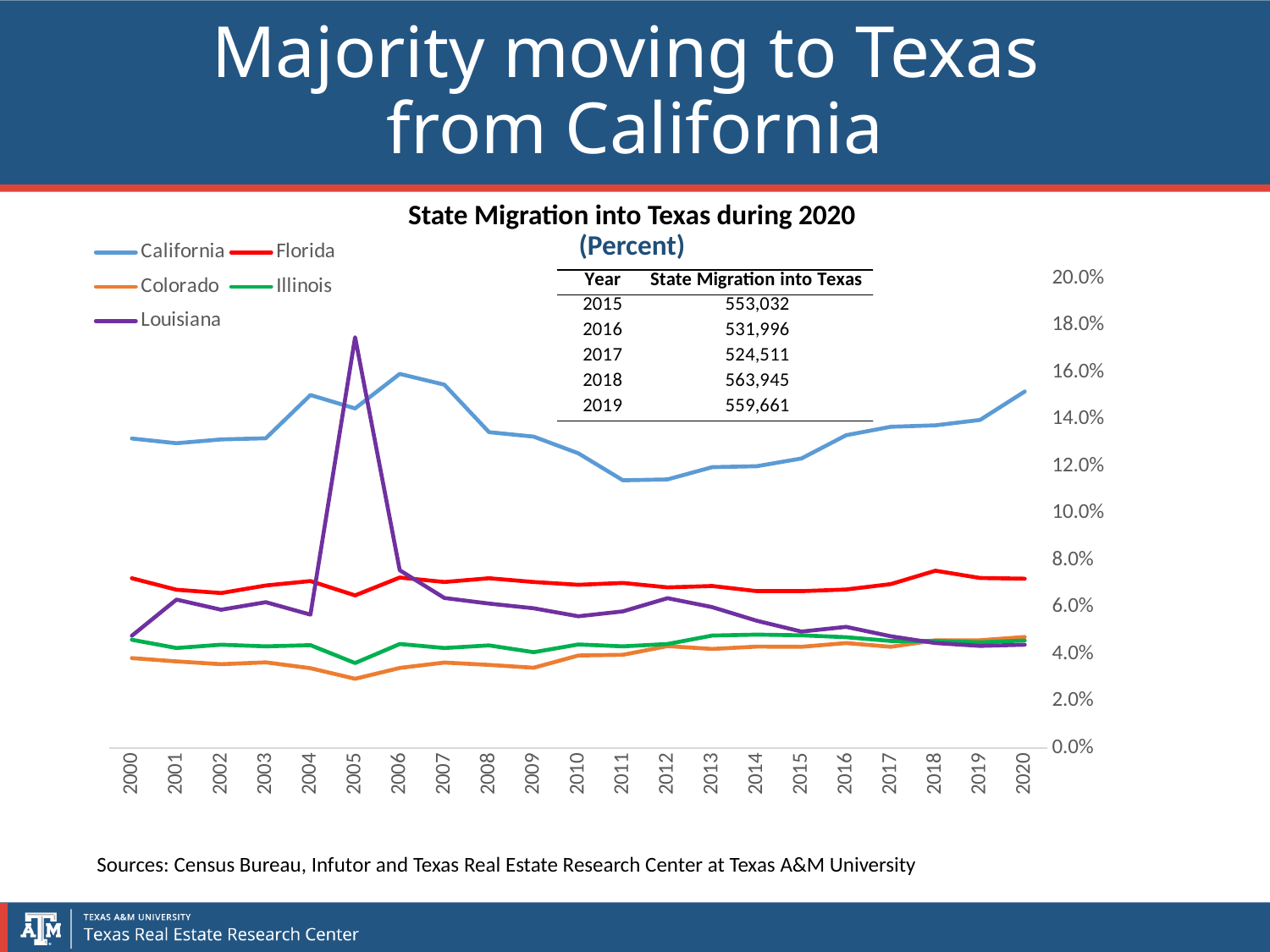
Is the value for Louisiana in 2005 greater or less than 16.0%? greater What is the title of the chart? State Migration into Texas during 2020 (Percent) Is the value for Colorado in 2005 greater or less than 4.0%? less Is the value for Florida in 2000 greater or less than 8.0%? less Does the California line rise or fall from 2011 to 2020? Rises In 2005, which is larger: the value for Louisiana or the value for California? Louisiana Which state has the lowest value in 2005? Colorado How many years are shown along the x axis of the chart? 21 Which state has the highest value in 2020? California How many series does the chart legend list? 5 What kind of chart is shown on the slide? Line chart